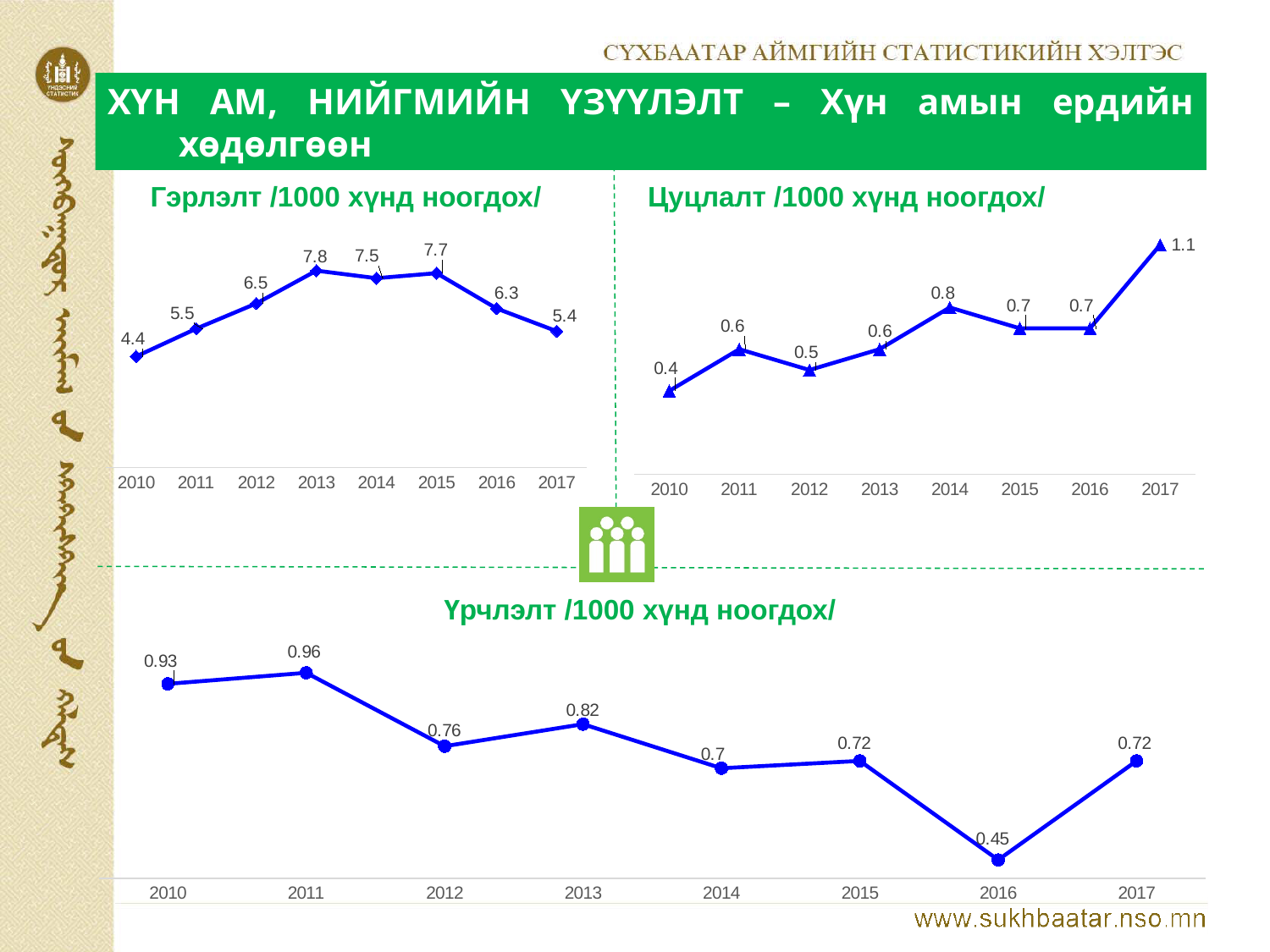
In the chart titled 'Цуцлалт /1000 хүнд ноогдох/', which year has the highest value? 2017 In the chart titled 'Гэрлэлт /1000 хүнд ноогдох/', which year has the lowest value? 2010 In the chart titled 'Үрчлэлт /1000 хүнд ноогдох/', what is the difference between the 2011 value and the 2016 value? 0.51 What kind of chart is the chart titled 'Гэрлэлт /1000 хүнд ноогдох/'? Line chart In the chart titled 'Үрчлэлт /1000 хүнд ноогдох/', does the value rise or fall from 2015 to 2016? Fall In the chart titled 'Үрчлэлт /1000 хүнд ноогдох/', what is the value for 2016? 0.45 In the chart titled 'Цуцлалт /1000 хүнд ноогдох/', what is the value for 2017? 1.1 In the chart titled 'Цуцлалт /1000 хүнд ноогдох/', which is larger, the value for 2014 or the value for 2012? 2014 In the chart titled 'Гэрлэлт /1000 хүнд ноогдох/', what is the value for 2013? 7.8 How many years are plotted in the chart titled 'Үрчлэлт /1000 хүнд ноогдох/'? 8 In the chart titled 'Гэрлэлт /1000 хүнд ноогдох/', what is the difference between the 2013 value and the 2010 value? 3.4 In the chart titled 'Үрчлэлт /1000 хүнд ноогдох/', which year has the highest value? 2011